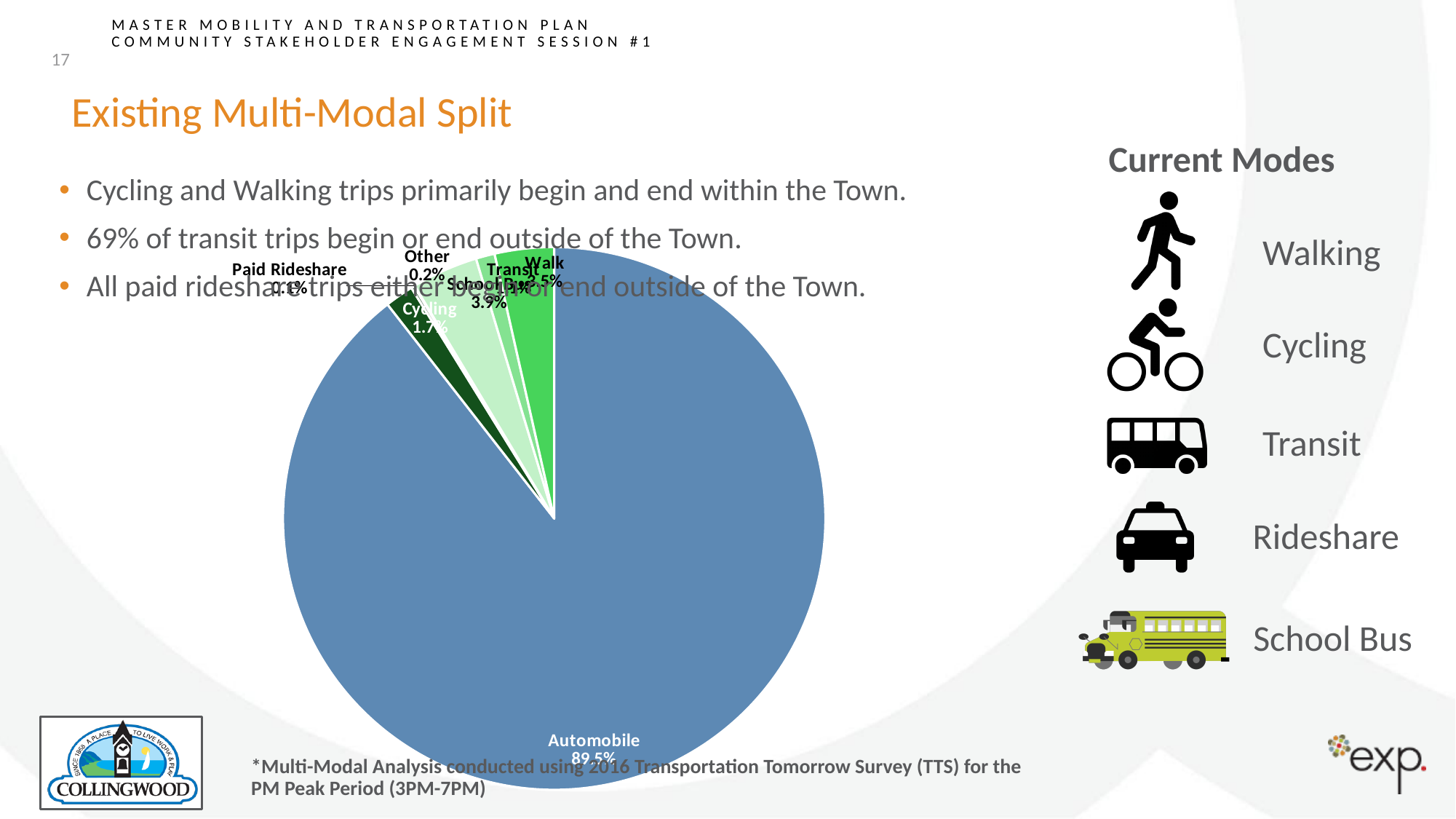
Which has a larger share in the pie chart, Walk or School Bus? School Bus What percentage is shown for Paid Rideshare in the pie chart? 0.1% What percentage is shown for Walk in the pie chart? 3.5% Which mode has the largest share in the pie chart? Automobile What percentage is shown for Other in the pie chart? 0.2% Which mode has the smallest share in the pie chart? Paid Rideshare What percentage is shown for School Bus in the pie chart? 3.9% What percentage of trips is shown for Automobile in the pie chart? 89.5% How many mode categories are shown in the pie chart? 7 What kind of chart is shown on the slide? pie chart What percentage is shown for Cycling in the pie chart? 1.7% What is the difference in percentage points between the School Bus share and the Cycling share? 2.2%